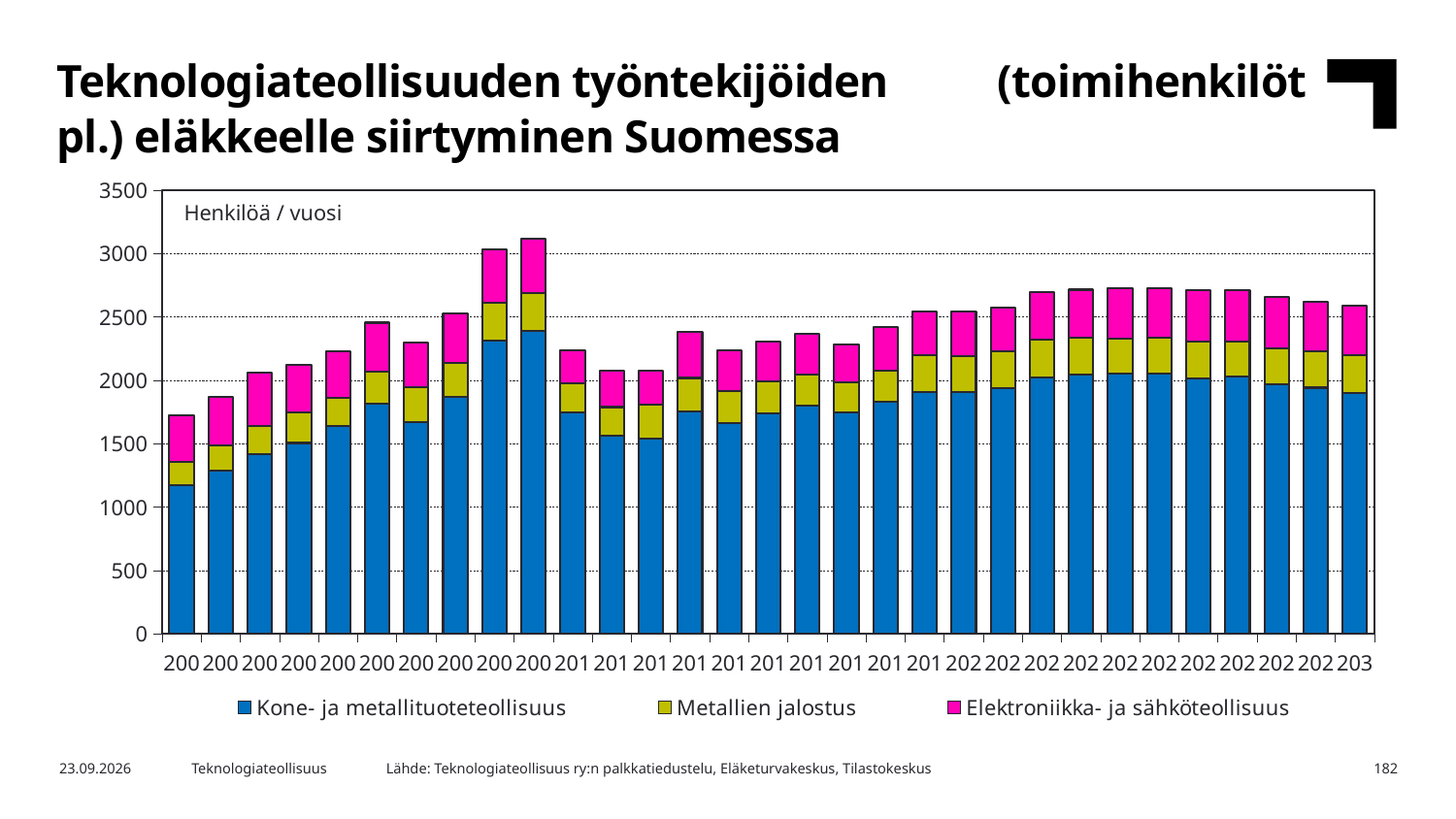
Is the total of the leftmost bar greater or less than 2000? less Which series forms the largest part of each stacked bar? Kone- ja metallituoteteollisuus What is the highest value shown on the y axis? 3500 Which series are listed in the legend? Kone- ja metallituoteteollisuus, Metallien jalostus, Elektroniikka- ja sähköteollisuus Is the total of the tallest bar greater or less than 3000? greater How many series does the legend list? 3 Is the total of the rightmost bar greater or less than 2500? greater What kind of chart is shown on the slide? Stacked bar chart What unit label is printed inside the plot area at the top left? Henkilöä / vuosi How many stacked bars are plotted in the chart? 31 Do the bar totals rise or fall across the first five bars from the left? rise Which bar has the larger total, the leftmost bar or the rightmost bar? The rightmost bar